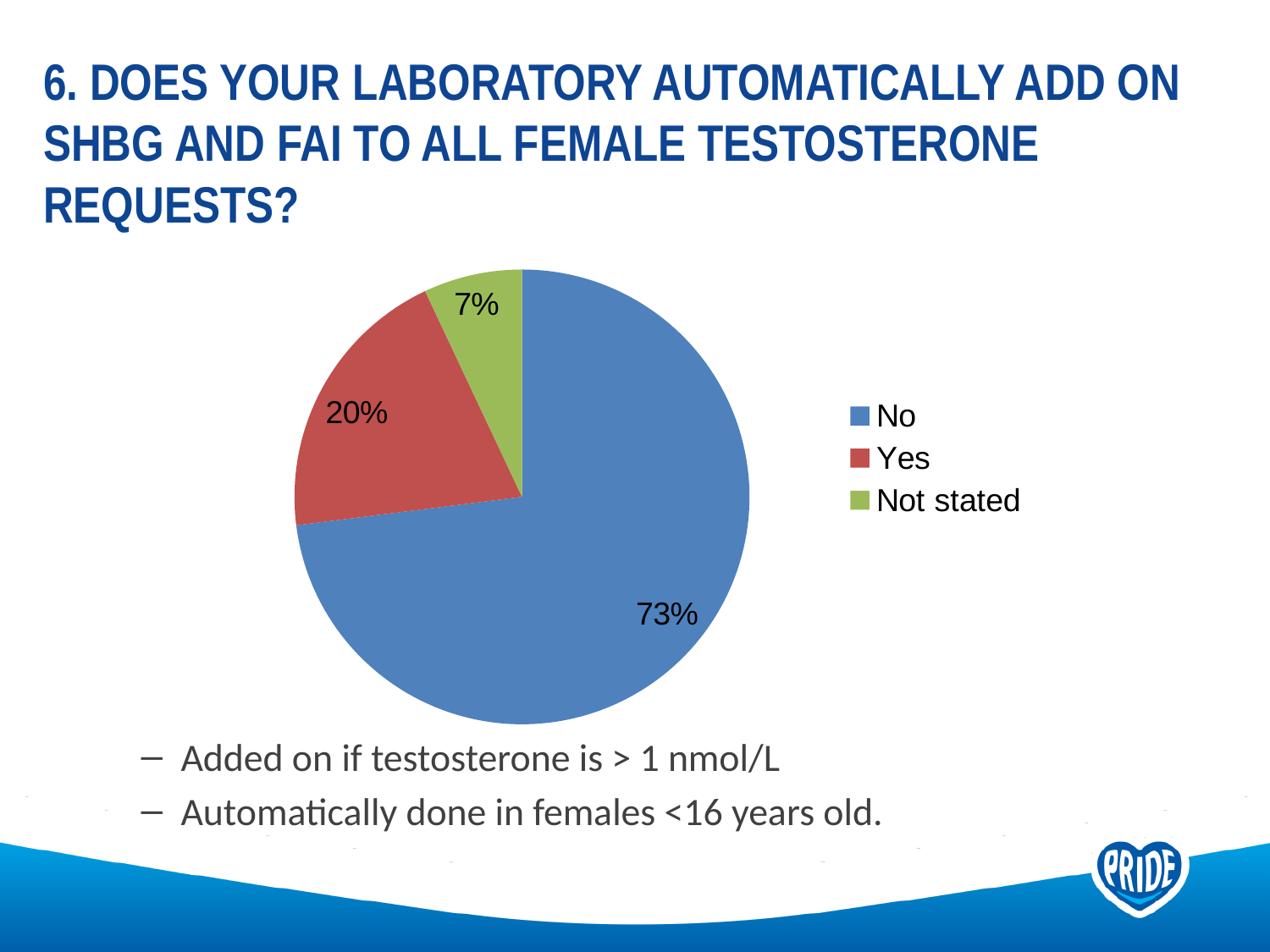
Which category has the smallest slice of the pie chart? Not stated What percentage of the pie chart is labelled "Not stated"? 7% What colour is the "Yes" slice in the pie chart? Red What is the difference in percentage points between the "No" and "Yes" slices? 53 What percentage of the pie chart is labelled "Yes"? 20% Which category has the largest slice of the pie chart? No What percentage of the pie chart is labelled "No"? 73% How many categories are shown in the pie chart? 3 What colour is the "Not stated" slice in the pie chart? Green What is the difference in percentage points between the "Yes" and "Not stated" slices? 13 What type of chart is shown on the slide? Pie chart Which slice is larger, "Yes" or "Not stated"? Yes